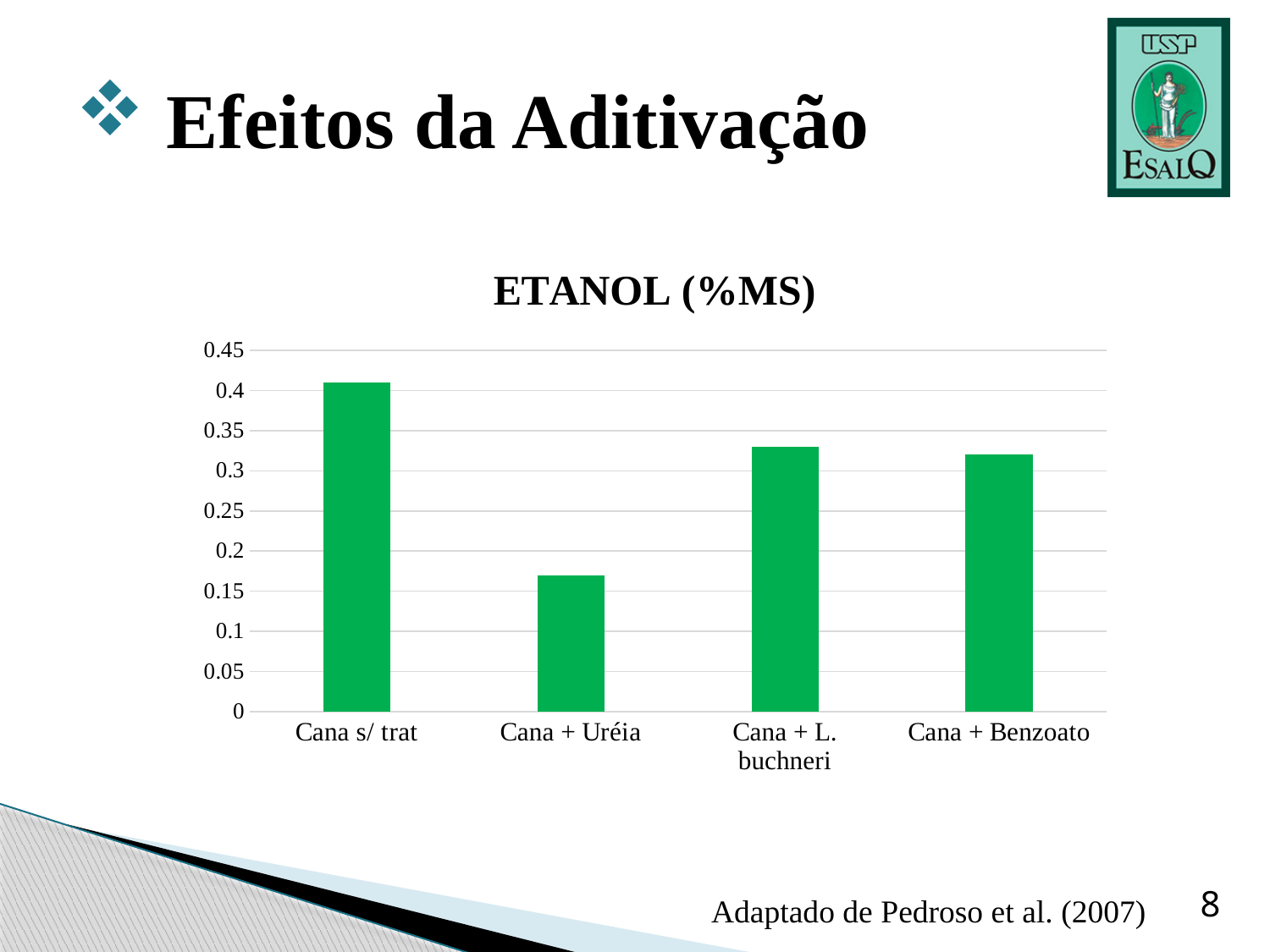
How many categories are shown on the x axis of the chart? 4 Which has a larger value, Cana + Uréia or Cana + L. buchneri? Cana + L. buchneri Which category has the lowest value in the chart? Cana + Uréia Is the value for Cana + L. buchneri greater or less than 0.3? greater What is the title of the chart? ETANOL (%MS) Which has a larger value, Cana s/ trat or Cana + Uréia? Cana s/ trat What type of chart is shown on the slide? bar chart Is the value for Cana s/ trat greater or less than 0.35? greater Which category has the highest value in the chart? Cana s/ trat What colour are the bars in the chart? green Is the value for Cana + Benzoato greater or less than 0.35? less